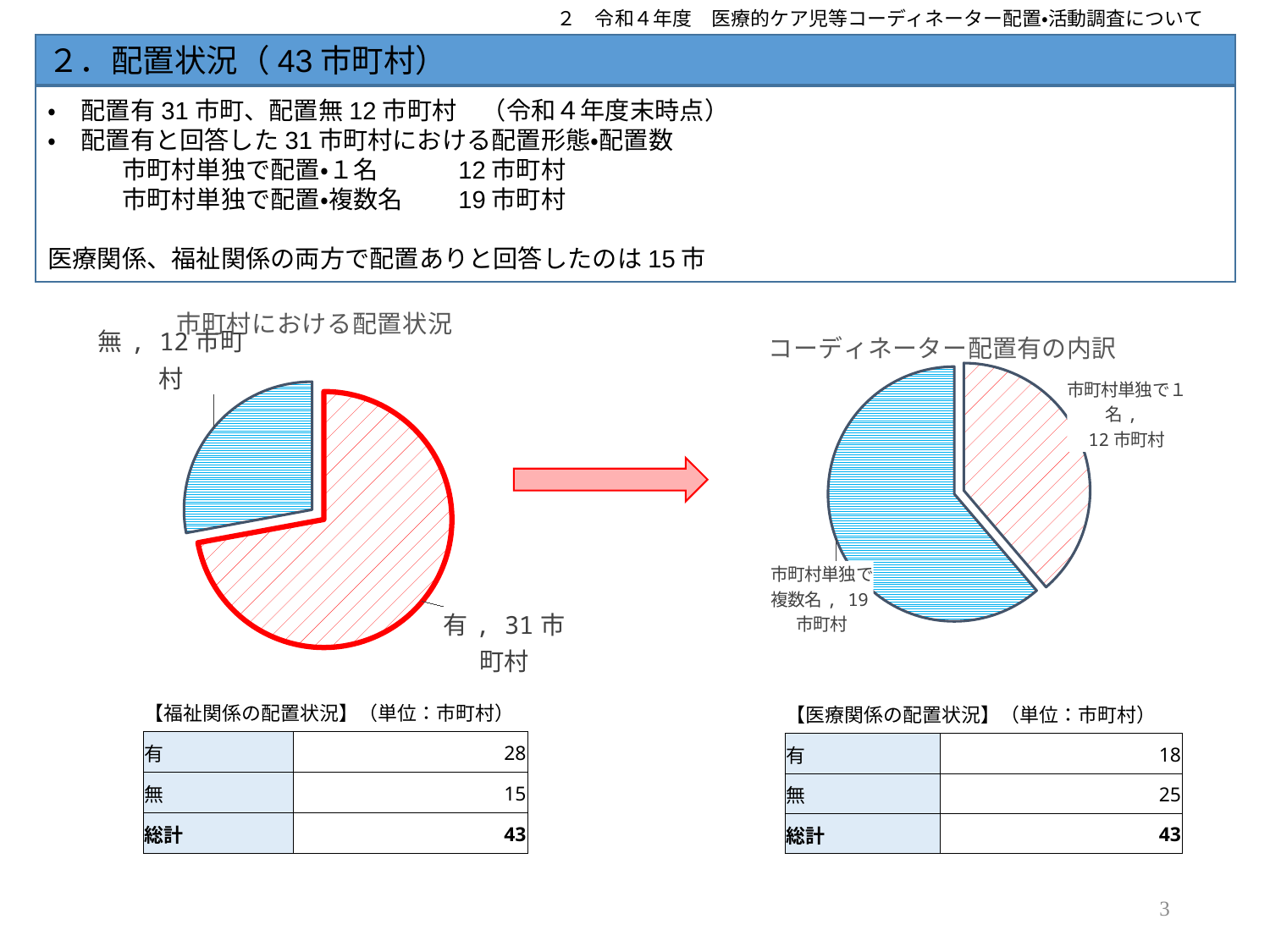
In the chart titled 市町村における配置状況, how many slices does the pie have? 2 What kind of chart is the chart titled 市町村における配置状況? pie chart In the chart titled 市町村における配置状況, what is the difference between the values for 有 and 無? 19 市町村 In the chart titled 市町村における配置状況, which category has the larger slice? 有 In the chart titled 市町村における配置状況, what is the value for 無? 12 市町村 What is the title of the pie chart on the right side of the slide? コーディネーター配置有の内訳 In the chart titled 市町村における配置状況, what is the value for 有? 31 市町村 In the chart titled コーディネーター配置有の内訳, what is the value for 市町村単独で1名? 12 市町村 In the chart titled コーディネーター配置有の内訳, what is the value for 市町村単独で複数名? 19 市町村 In the chart titled コーディネーター配置有の内訳, which category has the smaller slice? 市町村単独で1名 In the chart titled コーディネーター配置有の内訳, is the value for 市町村単独で複数名 larger or smaller than the value for 市町村単独で1名? larger In the chart titled コーディネーター配置有の内訳, what is the difference between the values for 市町村単独で複数名 and 市町村単独で1名? 7 市町村